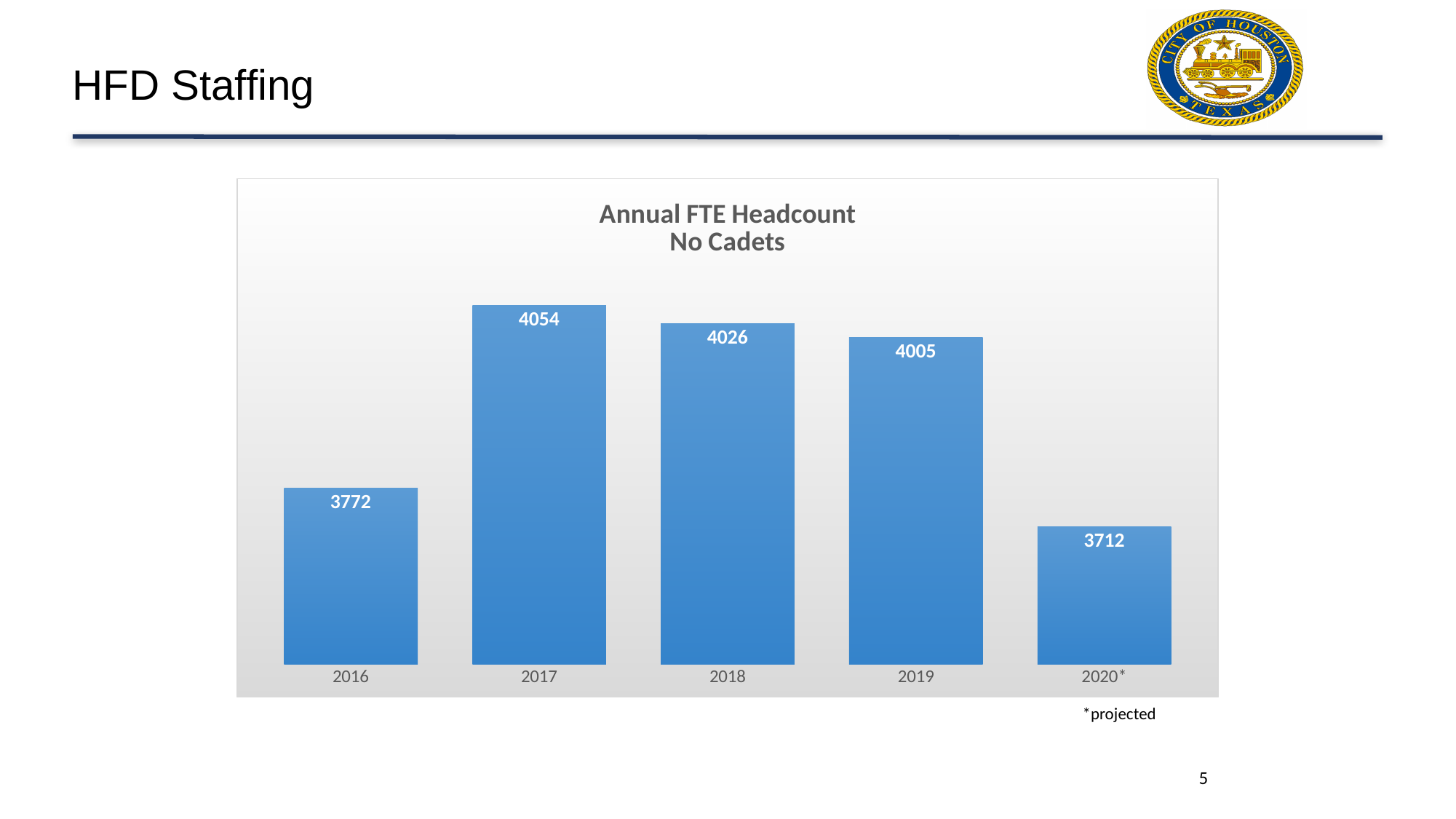
How many years are shown on the chart? 5 Which year has the highest FTE headcount? 2017 Which year has the lowest FTE headcount? 2020* What is the title of the chart? Annual FTE Headcount No Cadets Which year has a larger FTE headcount, 2016 or 2018? 2018 What kind of chart is shown on the slide? Bar chart What is the difference in FTE headcount between 2017 and 2020*? 342 What is the FTE headcount for 2017? 4054 What is the FTE headcount for 2016? 3772 What is the projected FTE headcount for 2020*? 3712 What is the FTE headcount for 2019? 4005 What is the difference in FTE headcount between 2018 and 2019? 21